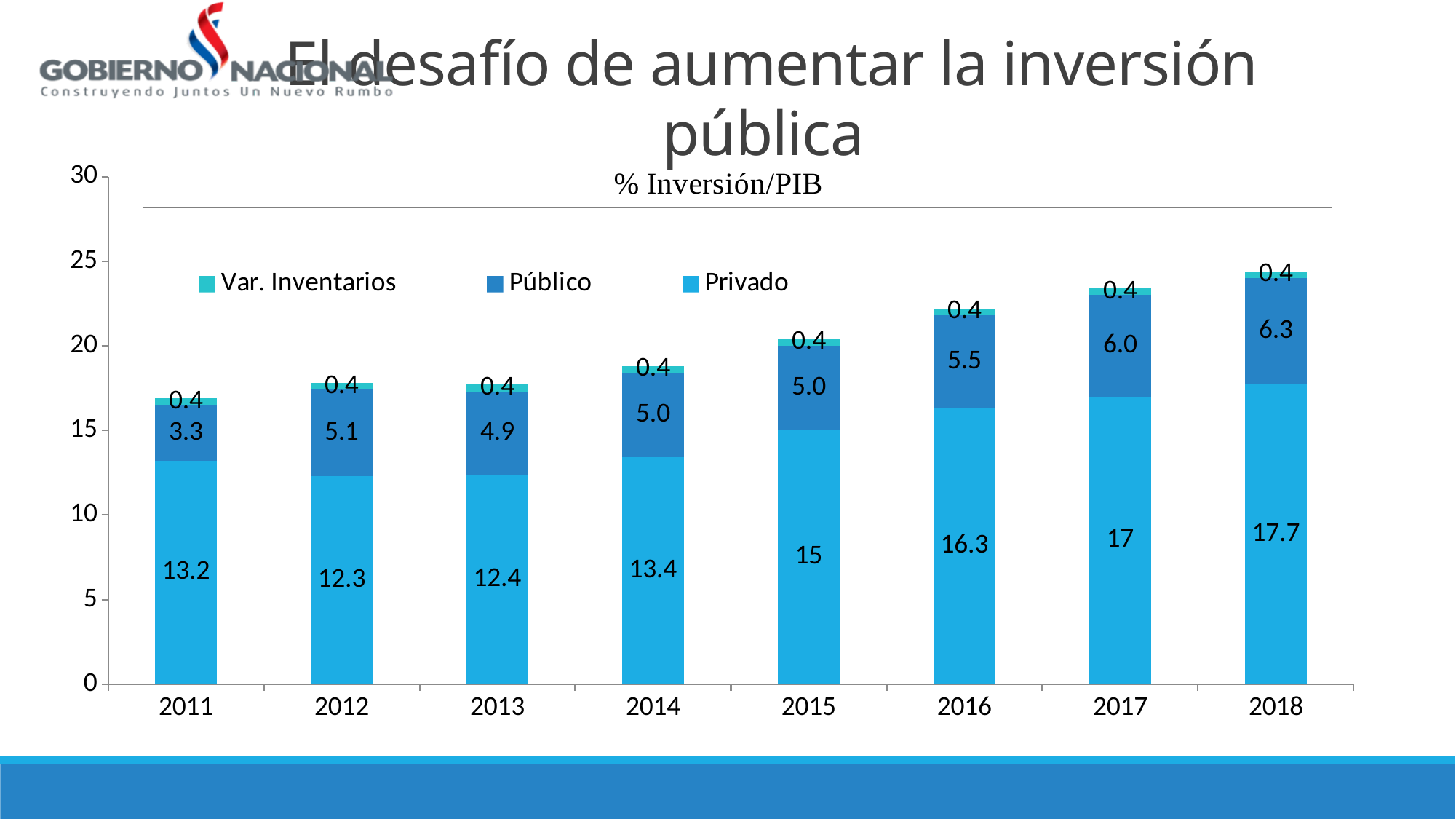
What is the Público value for 2018? 6.3 Which year has the highest Privado value? 2018 What is the Var. Inventarios value for 2011? 0.4 What is the difference between the Privado values for 2018 and 2011? 4.5 How many years are shown on the x axis? 8 What kind of chart is shown on the slide? Stacked bar chart Which is larger, the Público value for 2012 or for 2013? 2012 Which year has the lowest Público value? 2011 What is the total of the stacked bar for 2017? 23.4 How many series does the legend list? 3 What is the Privado value for 2015? 15 What is the title of the chart? % Inversión/PIB